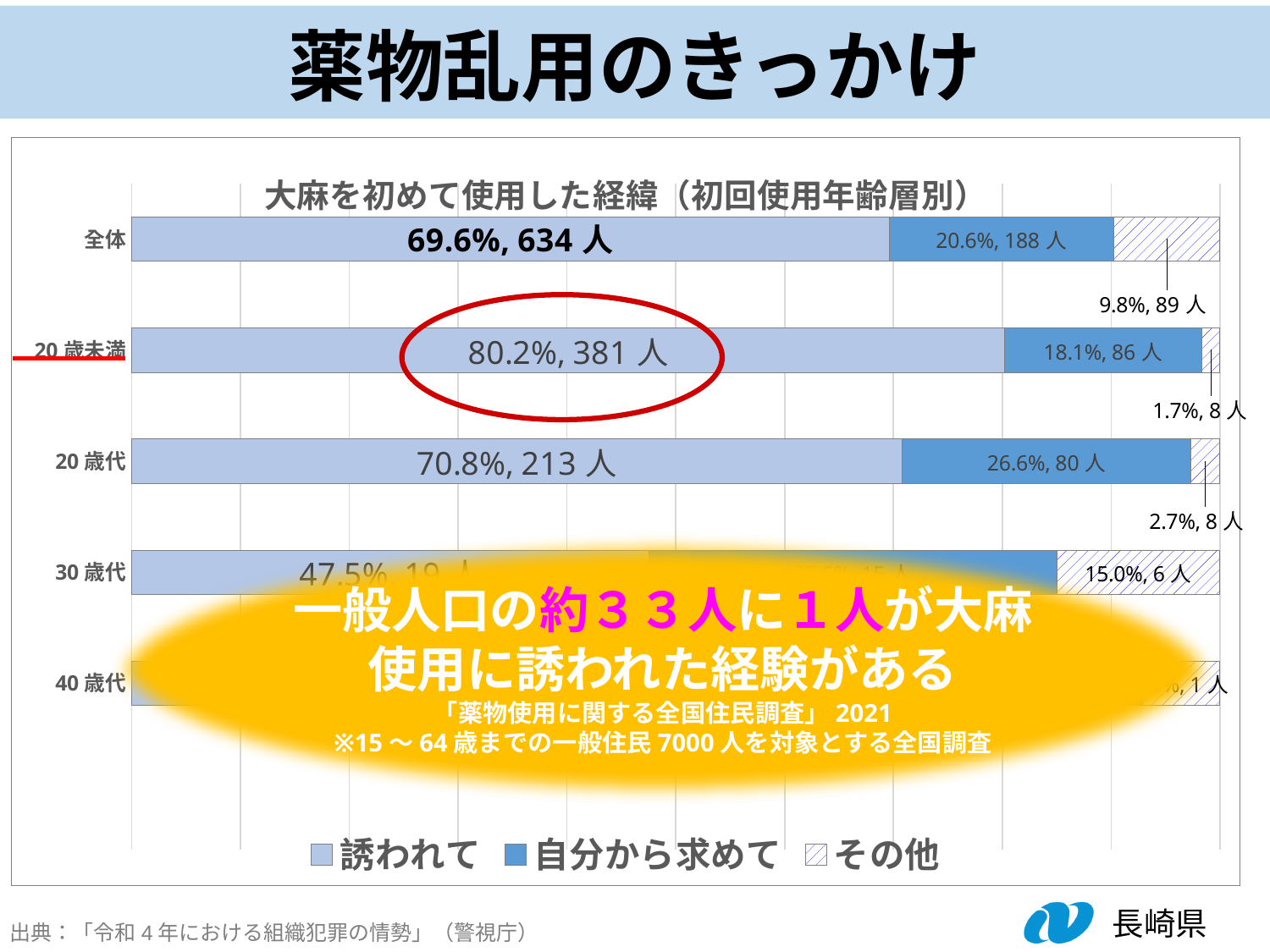
What is the title of the chart on the slide? 大麻を初めて使用した経緯（初回使用年齢層別） What is the value of その他 for 20歳代? 2.7%, 8人 What kind of chart is shown on the slide? Stacked bar chart Among 全体, 20歳未満 and 20歳代, which category has the highest 誘われて percentage? 20歳未満 What is the value of その他 for 全体? 9.8%, 89人 How many age-group categories are plotted in the chart? 5 What is the value of 自分から求めて for 全体? 20.6%, 188人 Which is larger for 20歳代: the number of people for 誘われて or for 自分から求めて? 誘われて What is the total number of people across all three series for 20歳未満? 475人 What is the value of 誘われて for 20歳未満? 80.2%, 381人 How many series does the chart legend list? 3 What is the difference in number of people between 誘われて and 自分から求めて for 全体? 446人